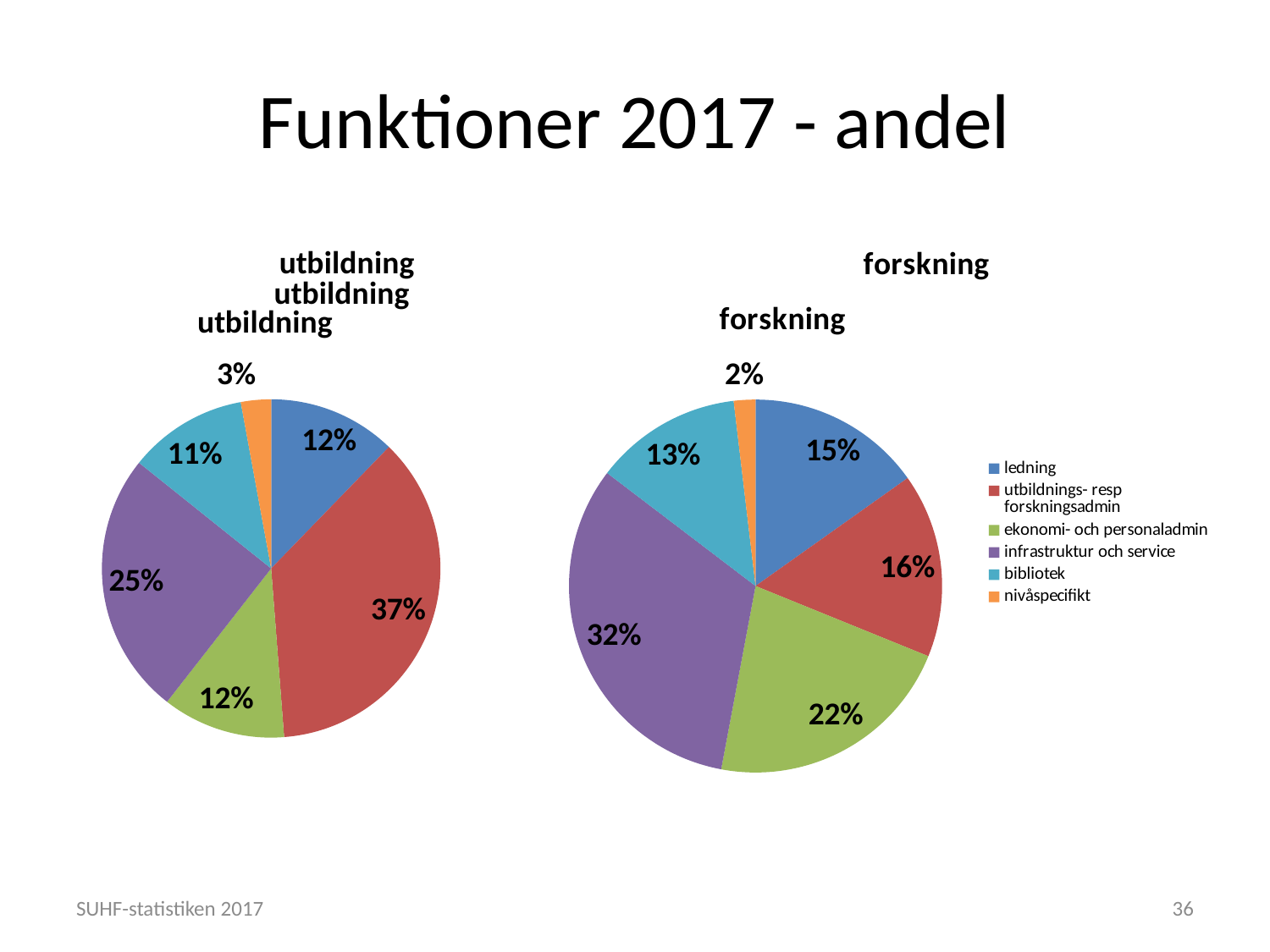
Is the share of ledning larger in the utbildning pie chart or in the forskning pie chart? forskning In the utbildning pie chart, what share does bibliotek have? 11% How many slices does the forskning pie chart have? 6 How many entries does the legend list? 6 In the forskning pie chart, what share does ekonomi- och personaladmin have? 22% In the forskning pie chart, what share does infrastruktur och service have? 32% In the forskning pie chart, which category has the smallest share? nivåspecifikt In the utbildning pie chart, what is the difference between the shares of infrastruktur och service and ledning? 13% In the utbildning pie chart, which category has the largest share? utbildnings- resp forskningsadmin In the utbildning pie chart, what share does utbildnings- resp forskningsadmin have? 37% What type of chart is used on this slide? pie chart In the forskning pie chart, which category has the largest share? infrastruktur och service